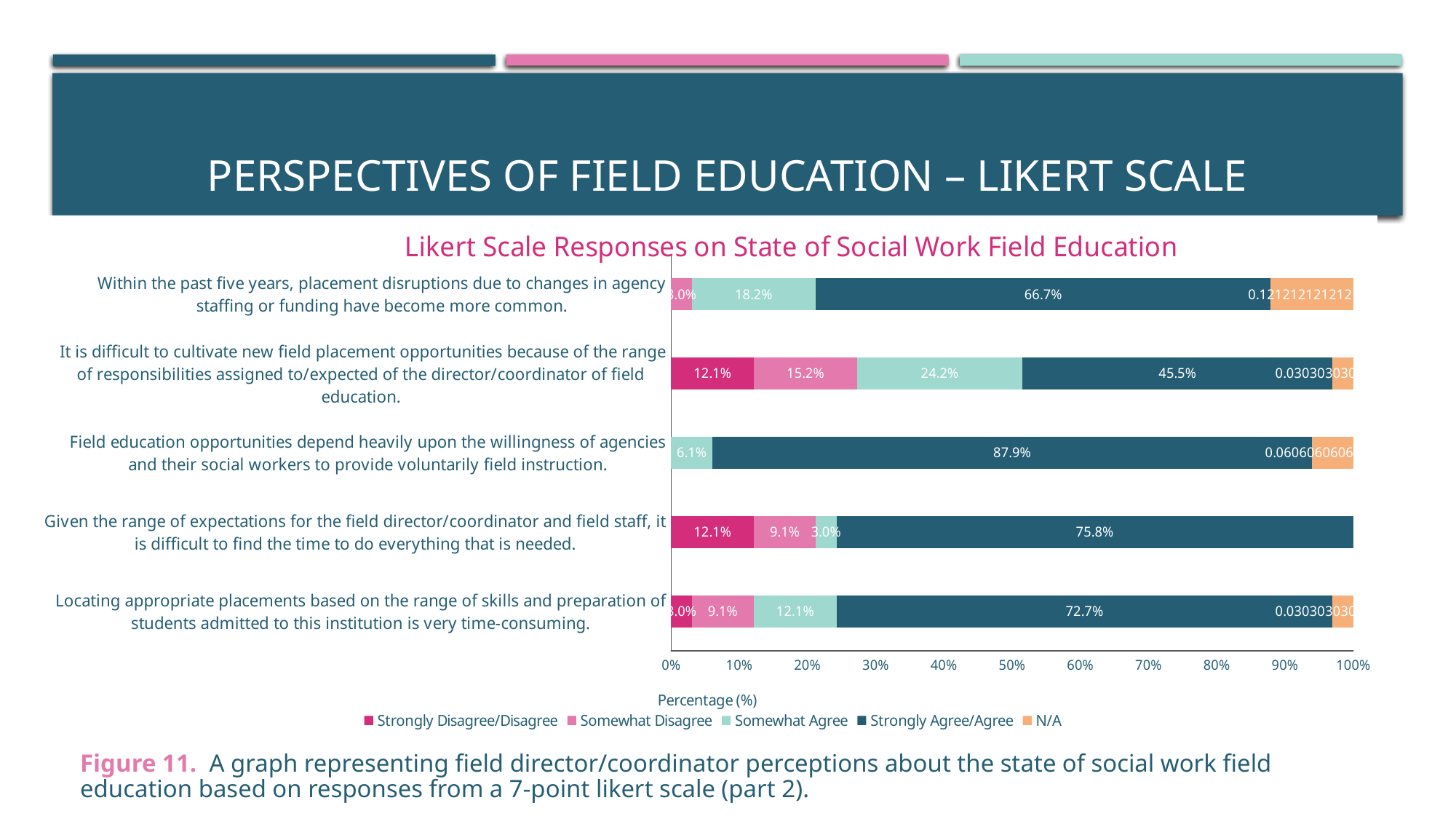
How many series does the legend list? 5 What kind of chart is shown on the slide? Stacked bar chart How many statements (categories) are plotted in the chart? 5 What is the Strongly Disagree/Disagree percentage for the statement 'Given the range of expectations for the field director/coordinator and field staff, it is difficult to find the time to do everything that is needed'? 12.1% Which statement has the lowest Strongly Agree/Agree percentage? It is difficult to cultivate new field placement opportunities because of the range of responsibilities assigned to/expected of the director/coordinator of field education. What is the difference in Strongly Agree/Agree percentage between the 'Field education opportunities depend heavily...' statement (87.9%) and the 'Given the range of expectations...' statement (75.8%)? 12.1% Which is larger: the Somewhat Disagree percentage for 'It is difficult to cultivate new field placement opportunities...' or the Somewhat Disagree percentage for 'Locating appropriate placements...'? It is difficult to cultivate new field placement opportunities... (15.2%) What is the Strongly Agree/Agree percentage for the statement 'Within the past five years, placement disruptions due to changes in agency staffing or funding have become more common'? 66.7% What is the Strongly Agree/Agree percentage for the statement 'Field education opportunities depend heavily upon the willingness of agencies and their social workers to provide voluntarily field instruction'? 87.9% What is the title of the chart? Likert Scale Responses on State of Social Work Field Education What is the Somewhat Agree percentage for the statement 'It is difficult to cultivate new field placement opportunities because of the range of responsibilities assigned to/expected of the director/coordinator of field education'? 24.2% Which statement has the highest Strongly Agree/Agree percentage? Field education opportunities depend heavily upon the willingness of agencies and their social workers to provide voluntarily field instruction.